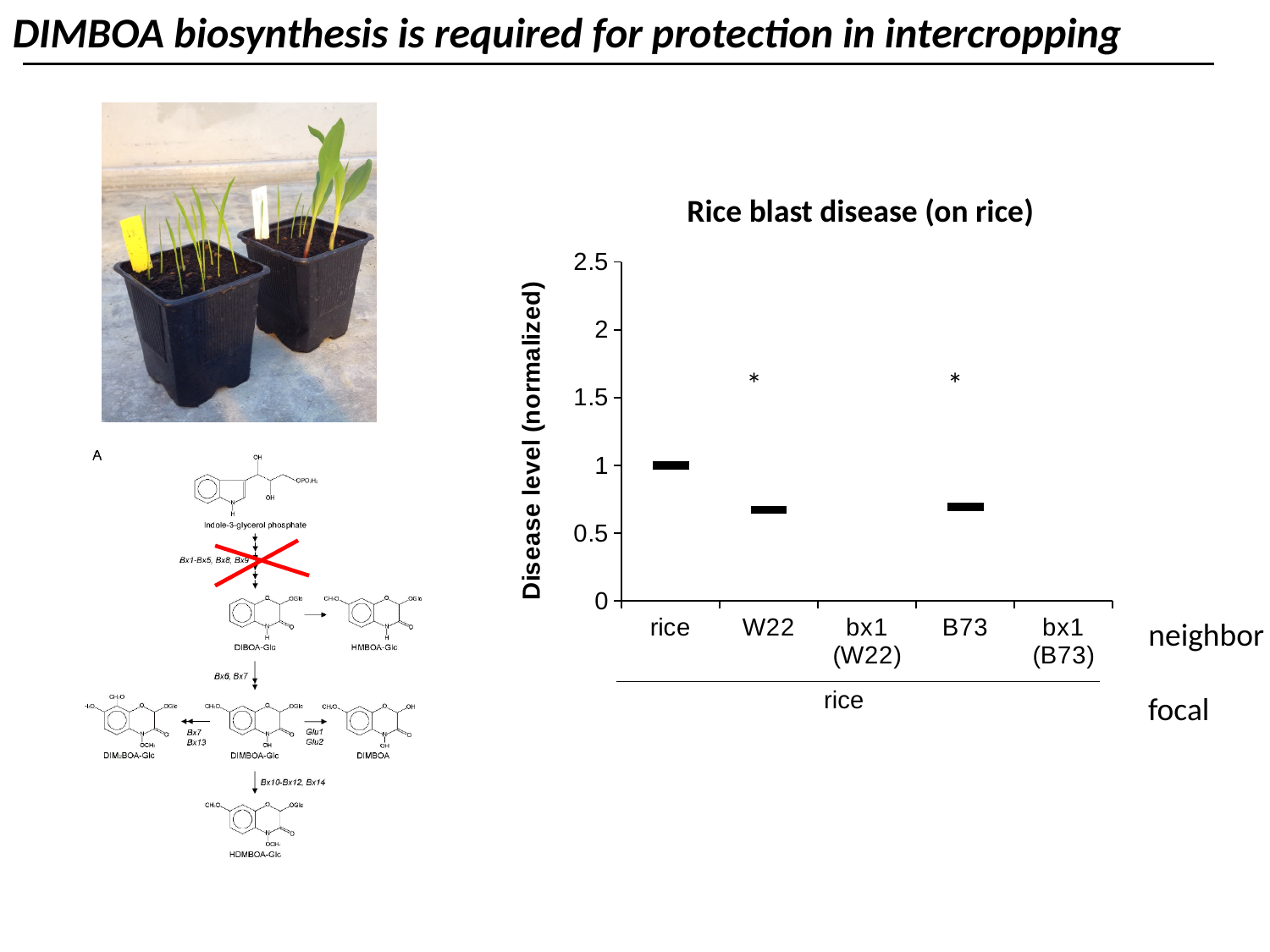
Is the disease level for the W22 neighbor greater or less than 0.5? greater How many neighbor categories have a plotted data point? 3 What is the disease level for the rice neighbor category? 1 What is the y-axis label of the chart? Disease level (normalized) Is the disease level for the W22 neighbor greater or less than 1? less Is the disease level for the B73 neighbor greater or less than 1? less How many neighbor categories are labeled on the x axis? 5 What is the title of the chart? Rice blast disease (on rice) Which neighbor category has the highest plotted disease level? rice What is the maximum value shown on the y axis? 2.5 Which has a higher disease level, the rice neighbor or the W22 neighbor? rice